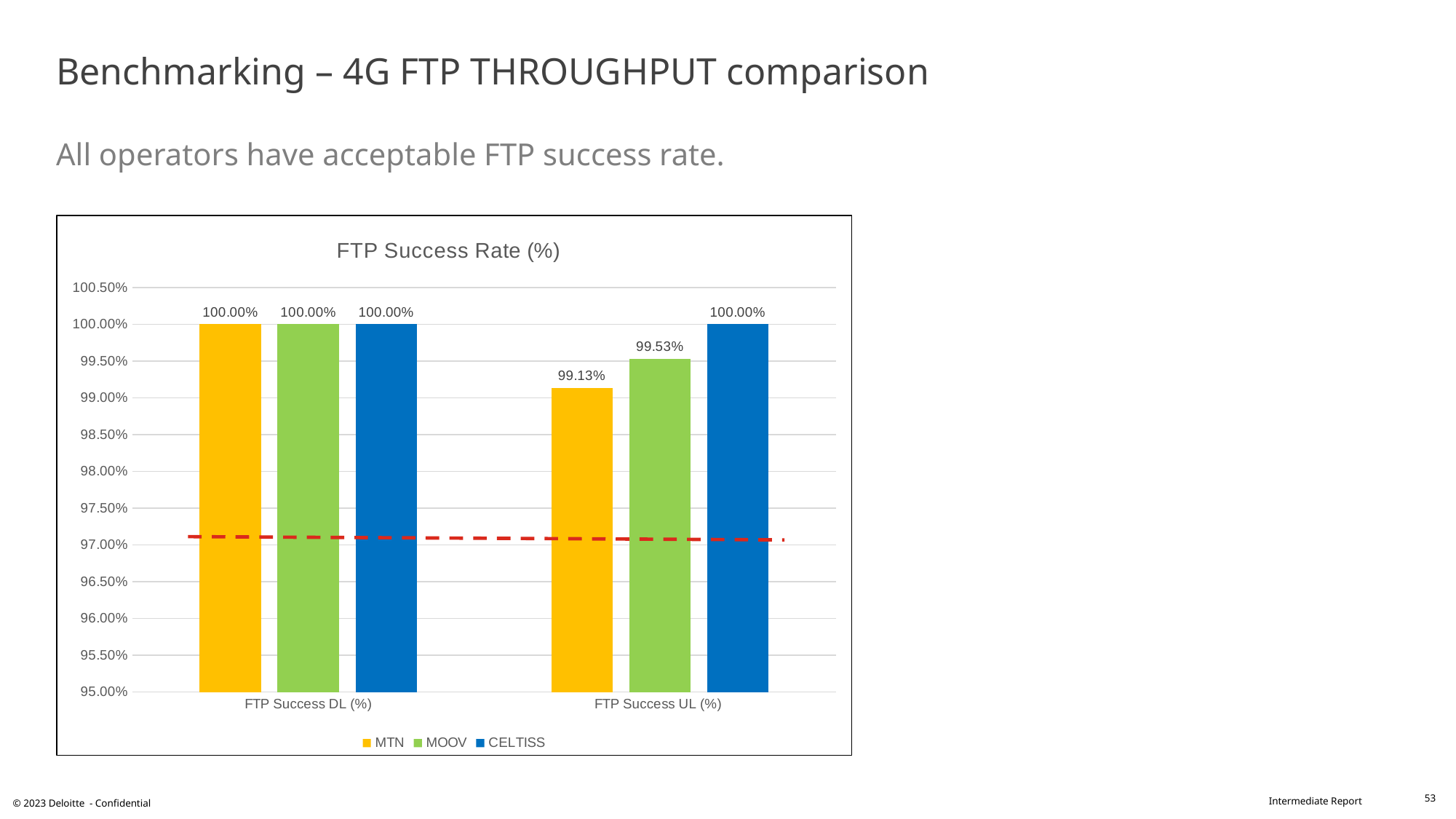
What kind of chart is shown on the slide? Bar chart What is the FTP Success UL (%) value for MTN? 99.13% How many categories are shown on the x axis? 2 Which is larger, MOOV's FTP Success UL (%) or MTN's FTP Success UL (%)? MOOV How many series does the legend list? 3 Which operator has the lowest FTP Success UL (%)? MTN What is the FTP Success UL (%) value for MOOV? 99.53% What is the title of the chart? FTP Success Rate (%) What is the difference between MOOV and MTN for FTP Success UL (%)? 0.40% What is the difference between CELTISS and MTN for FTP Success UL (%)? 0.87% What is the FTP Success DL (%) value for CELTISS? 100.00% Which operator has the highest FTP Success UL (%)? CELTISS